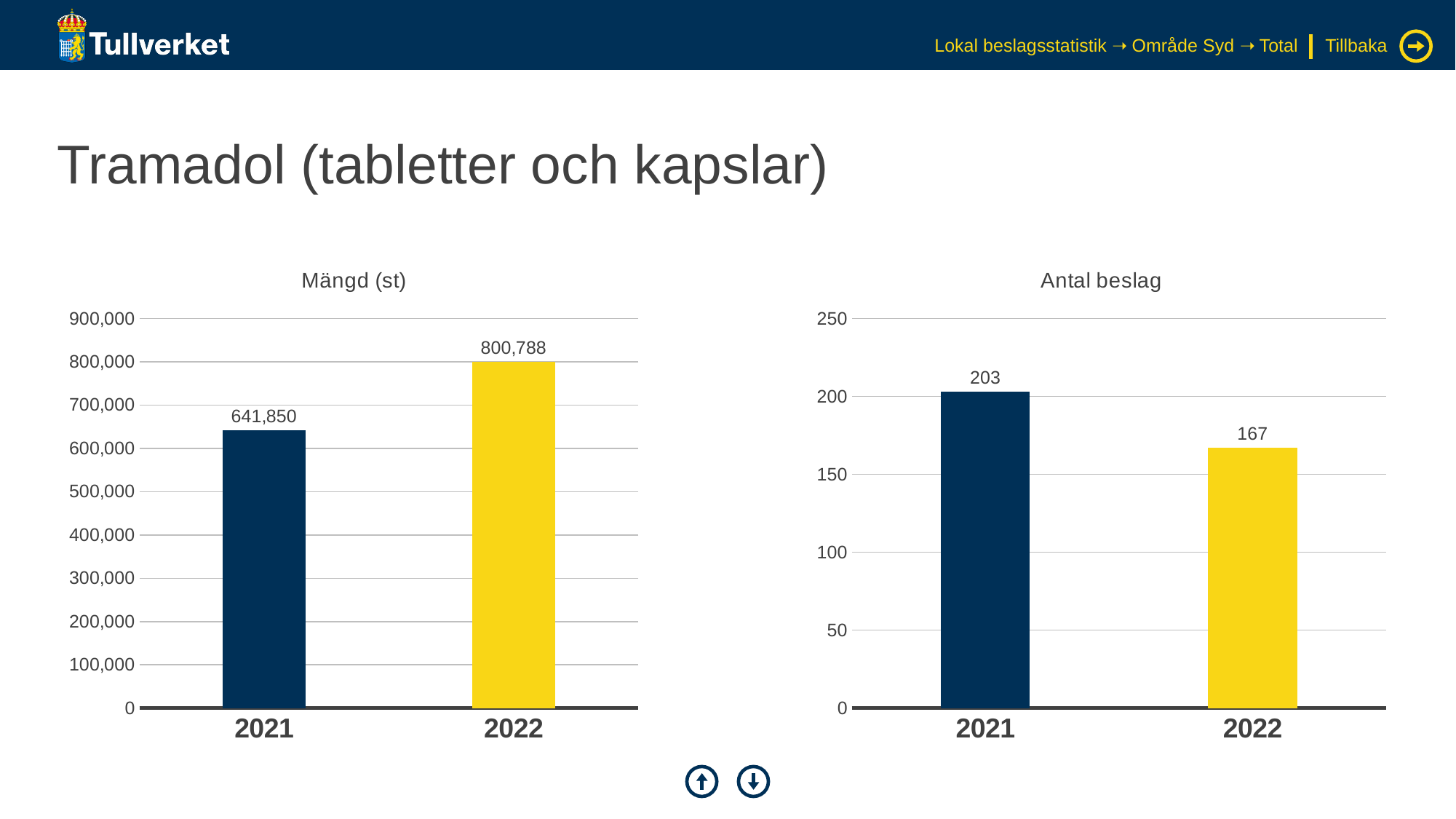
In the "Mängd (st)" chart, what is the difference between the 2022 and 2021 values? 158,938 In the "Antal beslag" chart, what is the value for 2022? 167 In the "Mängd (st)" chart, what is the value for 2022? 800,788 In the "Antal beslag" chart, which year has the lowest value? 2022 In the "Mängd (st)" chart, what is the value for 2021? 641,850 In the "Mängd (st)" chart, which year has the highest value? 2022 In the "Mängd (st)" chart, do the values rise or fall from 2021 to 2022? rise How many bars are in the "Antal beslag" chart? 2 In the "Antal beslag" chart, what is the difference between the 2021 and 2022 values? 36 What kind of chart is the "Mängd (st)" chart? bar chart In the "Antal beslag" chart, what is the value for 2021? 203 In the "Antal beslag" chart, is the value for 2021 larger or smaller than the value for 2022? larger